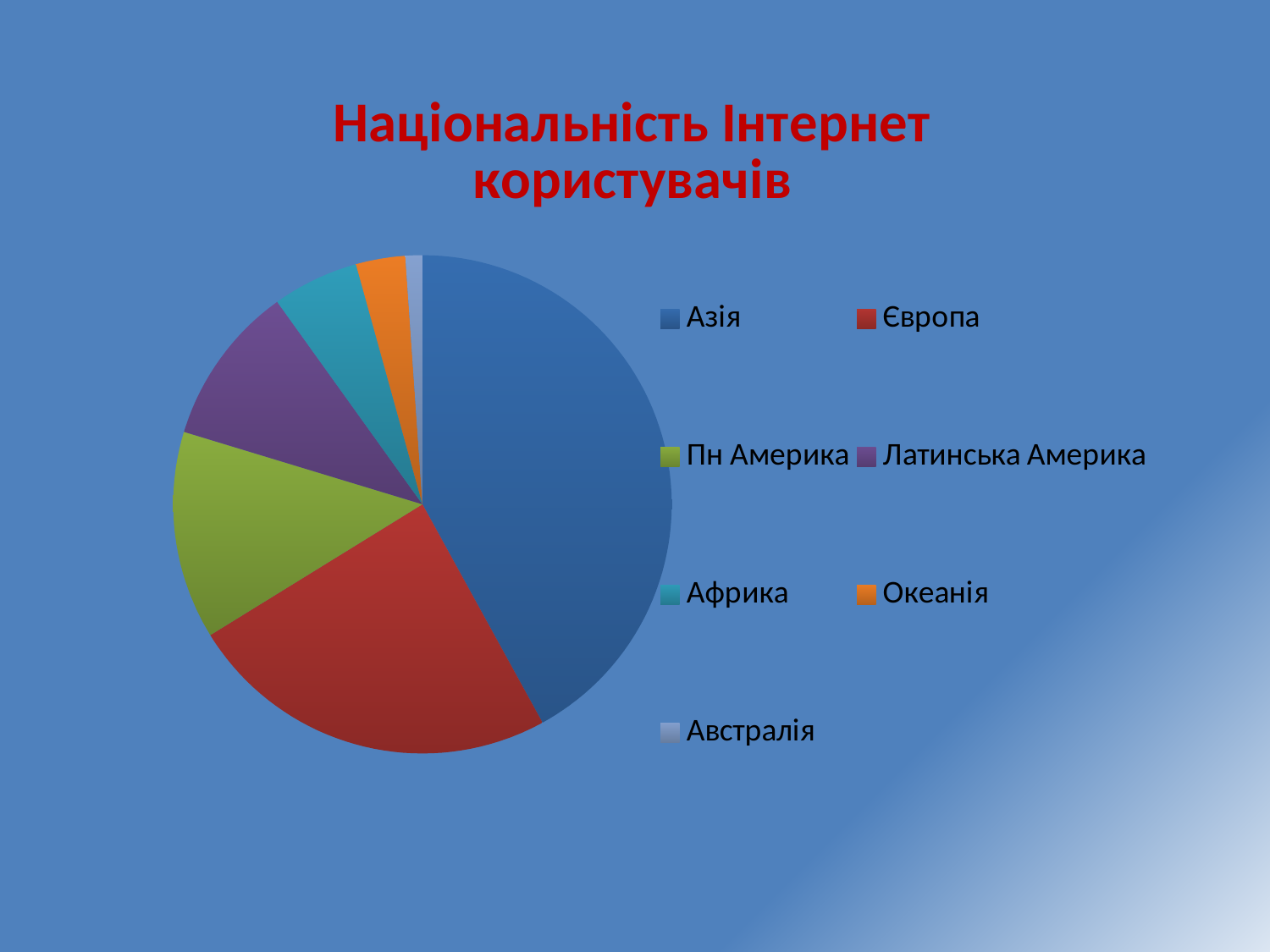
Which slice is larger, Азія or Європа? Азія Which slice is larger, Латинська Америка or Африка? Латинська Америка What colour is the slice for Азія in the pie chart? blue Which category has the smallest slice of the pie chart? Австралія Which slice is larger, Європа or Пн Америка? Європа What kind of chart is shown on the slide? pie chart What is the title of the chart on the slide? Національність Інтернет користувачів Which category has the largest slice of the pie chart? Азія How many slices does the pie chart have? 7